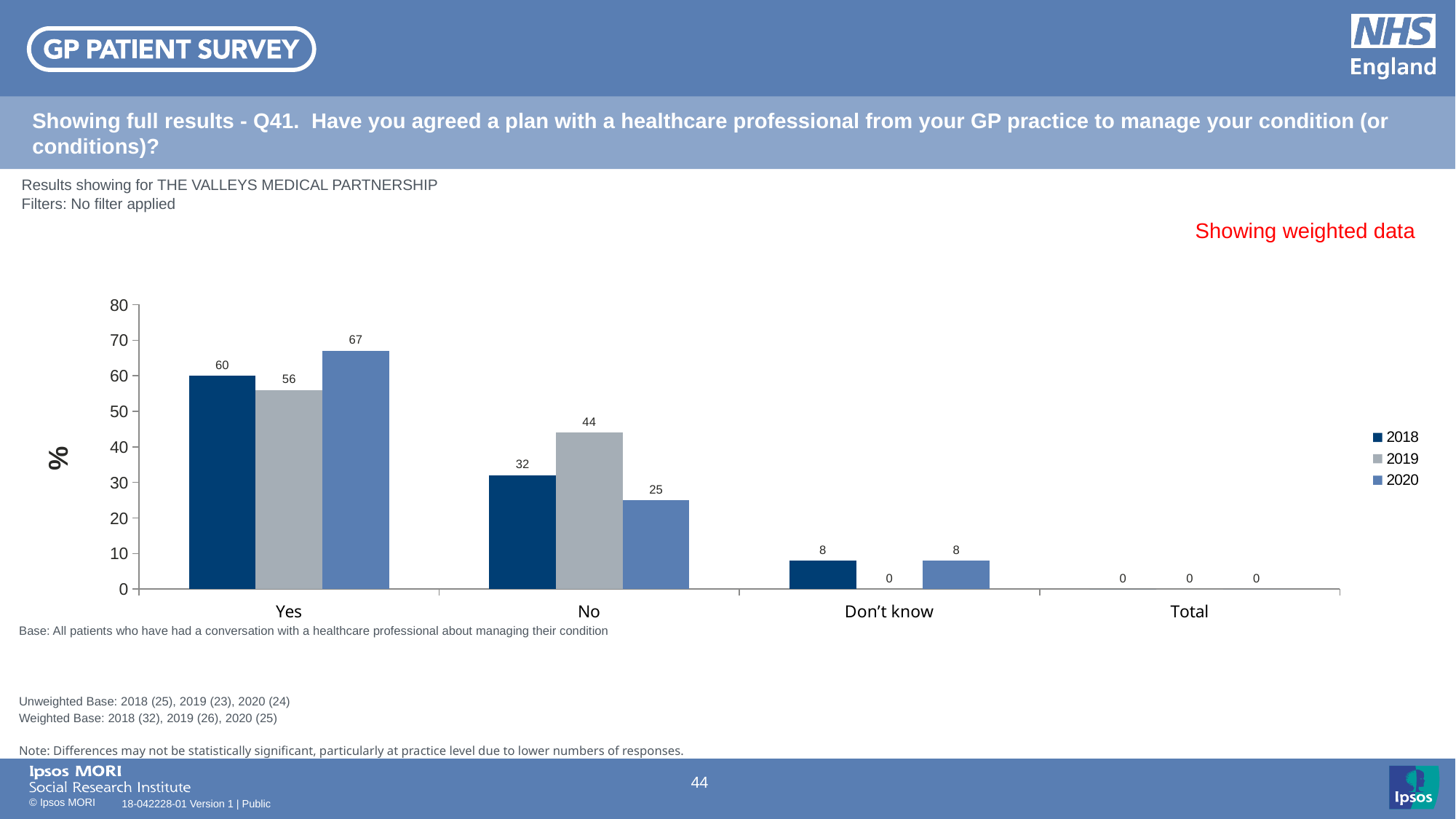
What is the value for 'Yes' in 2020? 67 How many categories are shown on the x axis? 4 What kind of chart is shown on the slide? Bar chart What is the value for 'No' in 2019? 44 Which year has the lowest value for 'No'? 2020 What is the difference between the 2020 and 2019 values for 'Yes'? 11 Which year has the highest value for 'Yes'? 2020 What is the value for 'Don't know' in 2018? 8 What label is shown on the y axis? % How many series does the legend list? 3 What is the difference between the 2019 and 2018 values for 'No'? 12 Which is larger: the 2018 value for 'Yes' or the 2019 value for 'Yes'? 2018